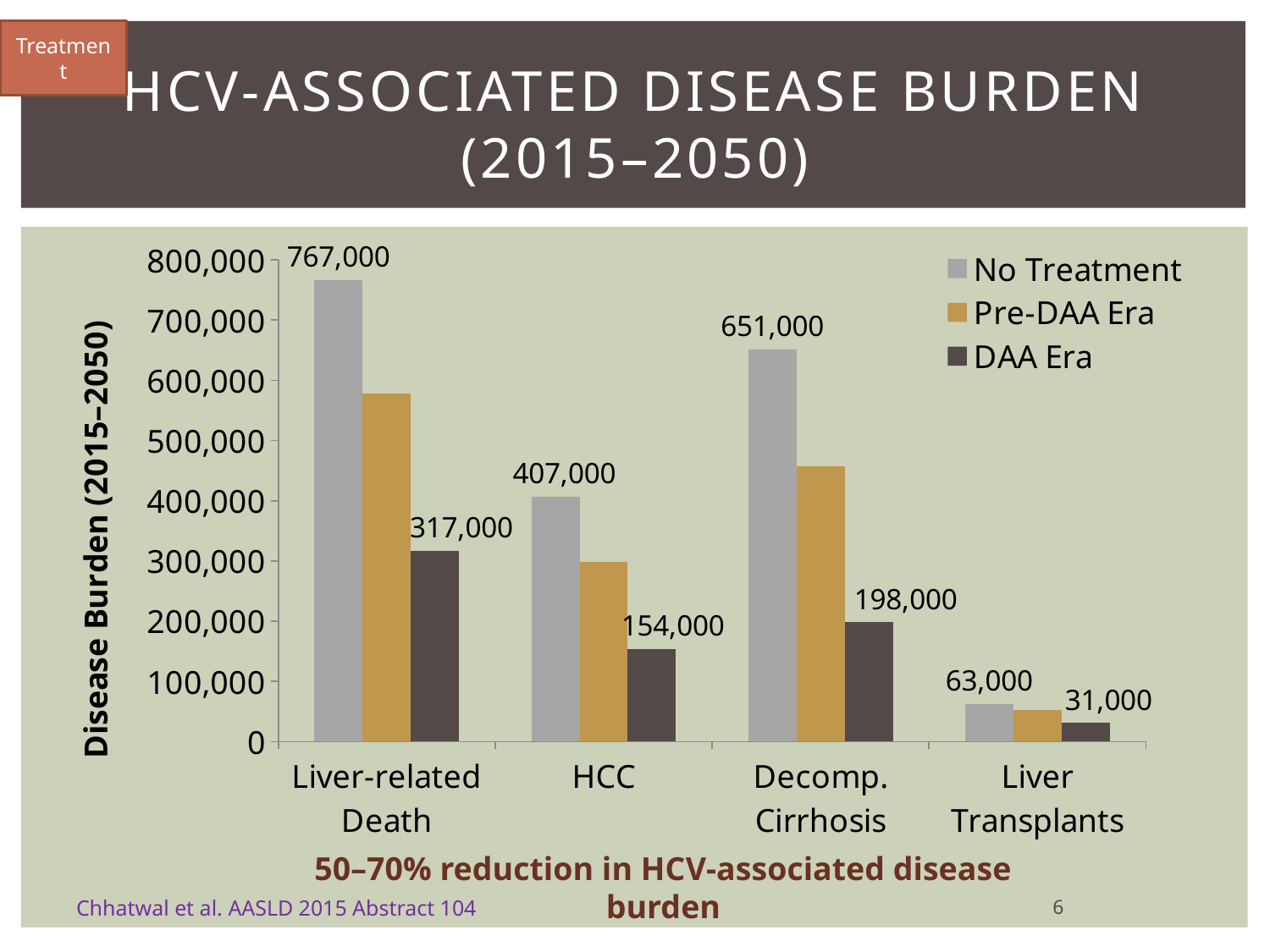
How many series does the legend list? 3 What is the DAA Era value for Decomp. Cirrhosis? 198,000 What is the No Treatment value for Liver-related Death? 767,000 Is the Pre-DAA Era value for Liver-related Death greater or less than 500,000? greater What is the No Treatment value for Liver Transplants? 63,000 Which is larger: the No Treatment value for HCC or the No Treatment value for Decomp. Cirrhosis? Decomp. Cirrhosis Which category has the highest No Treatment value? Liver-related Death What is the DAA Era value for HCC? 154,000 How many categories are shown on the x axis? 4 What kind of chart is shown on the slide? Bar chart What is the difference between the No Treatment and DAA Era values for Liver-related Death? 450,000 Which category has the lowest DAA Era value? Liver Transplants